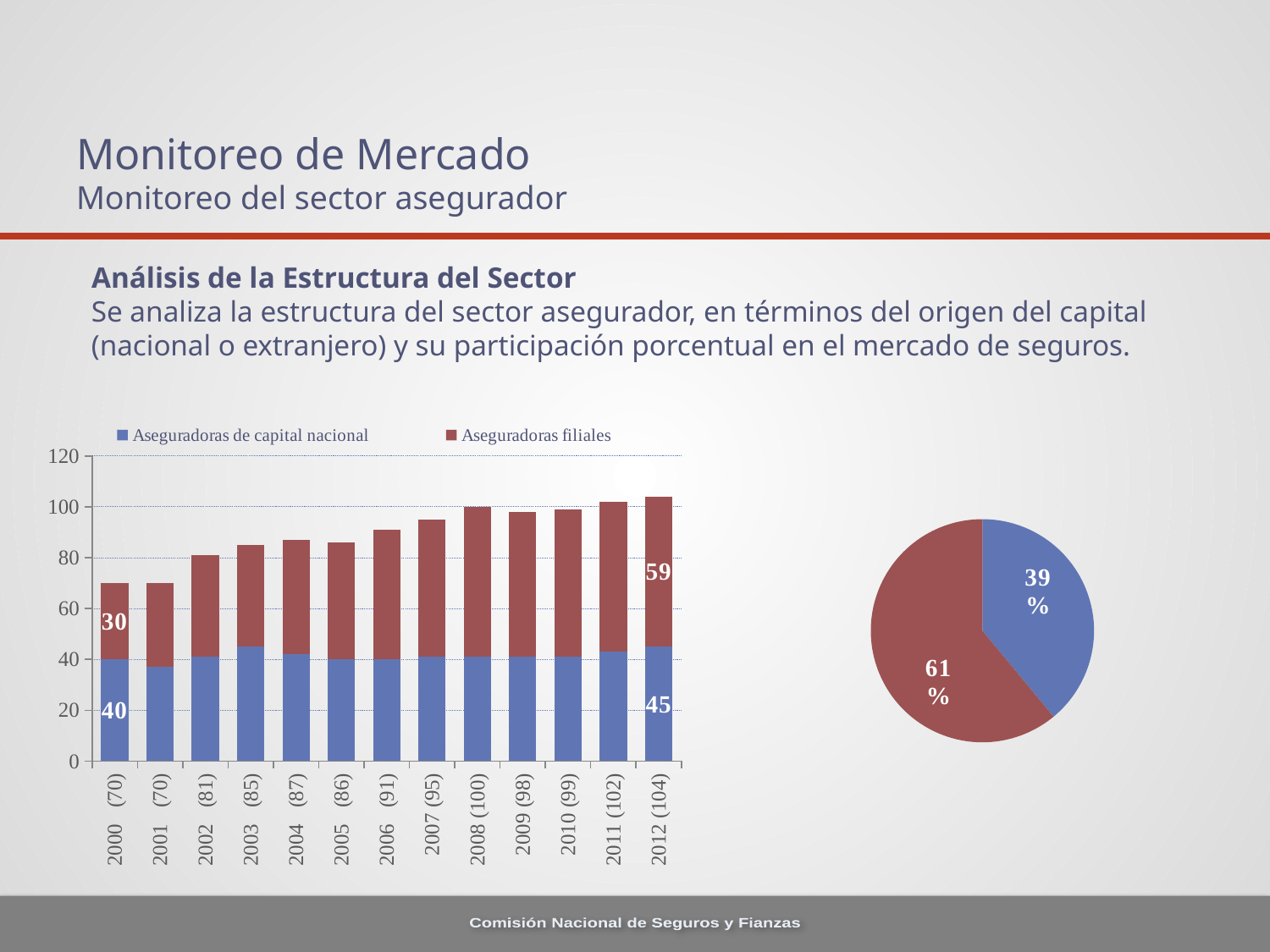
In the stacked bar chart on the left, how many years are shown on the x axis? 13 In the stacked bar chart on the left, is the total bar for 2005 greater or less than 100? less In the stacked bar chart on the left, what is the value for Aseguradoras filiales in 2012? 59 In the stacked bar chart on the left, how many series does the legend list? 2 In the stacked bar chart on the left, what is the difference between the Aseguradoras filiales value in 2012 and in 2000? 29 In the pie chart on the right, what share does the larger slice represent? 61% What kind of chart is shown on the right of the slide? pie chart In the stacked bar chart on the left, what is the total of the stacked bar for 2012? 104 In the stacked bar chart on the left, which year has the highest total bar? 2012 In the stacked bar chart on the left, what is the total of the stacked bar for 2008? 100 In the stacked bar chart on the left, what is the value for Aseguradoras de capital nacional in 2000? 40 In the stacked bar chart on the left, what is the value for Aseguradoras de capital nacional in 2012? 45